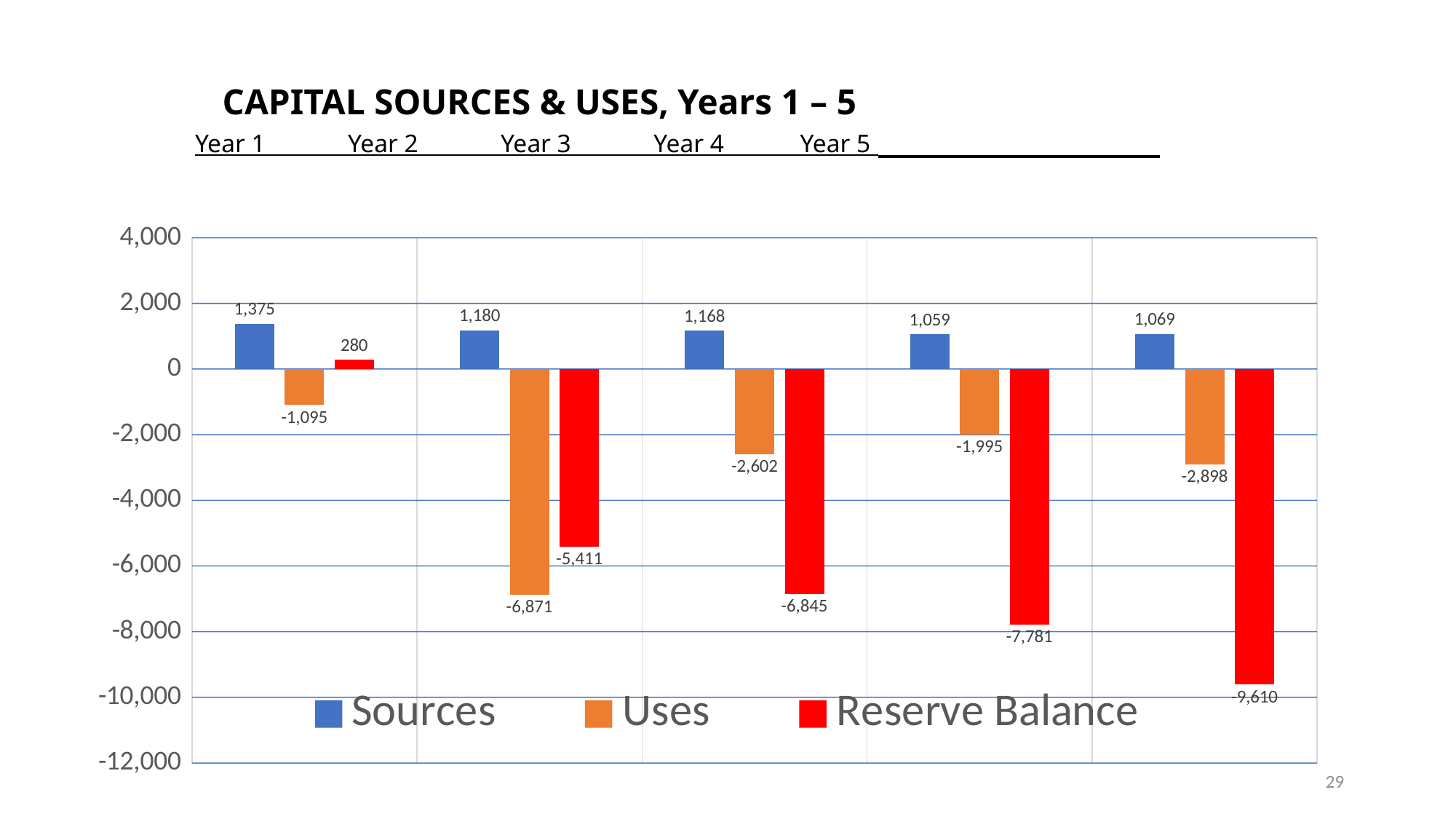
What is the Reserve Balance in Year 2? -5,411 What is the value of Uses in Year 3? -2,602 Which is larger, the Sources value in Year 2 or the Sources value in Year 4? Year 2 In which year is the Sources value highest? Year 1 Does the Reserve Balance rise or fall from Year 1 to Year 5? Fall What is the difference between Sources and Uses in Year 1? 2,470 What is the Reserve Balance in Year 5? -9,610 In which year is the Uses value lowest (most negative)? Year 2 What kind of chart is shown on the slide? Bar chart What is the value of Sources in Year 1? 1,375 How many series does the legend list? 3 How many years are shown on the chart? 5